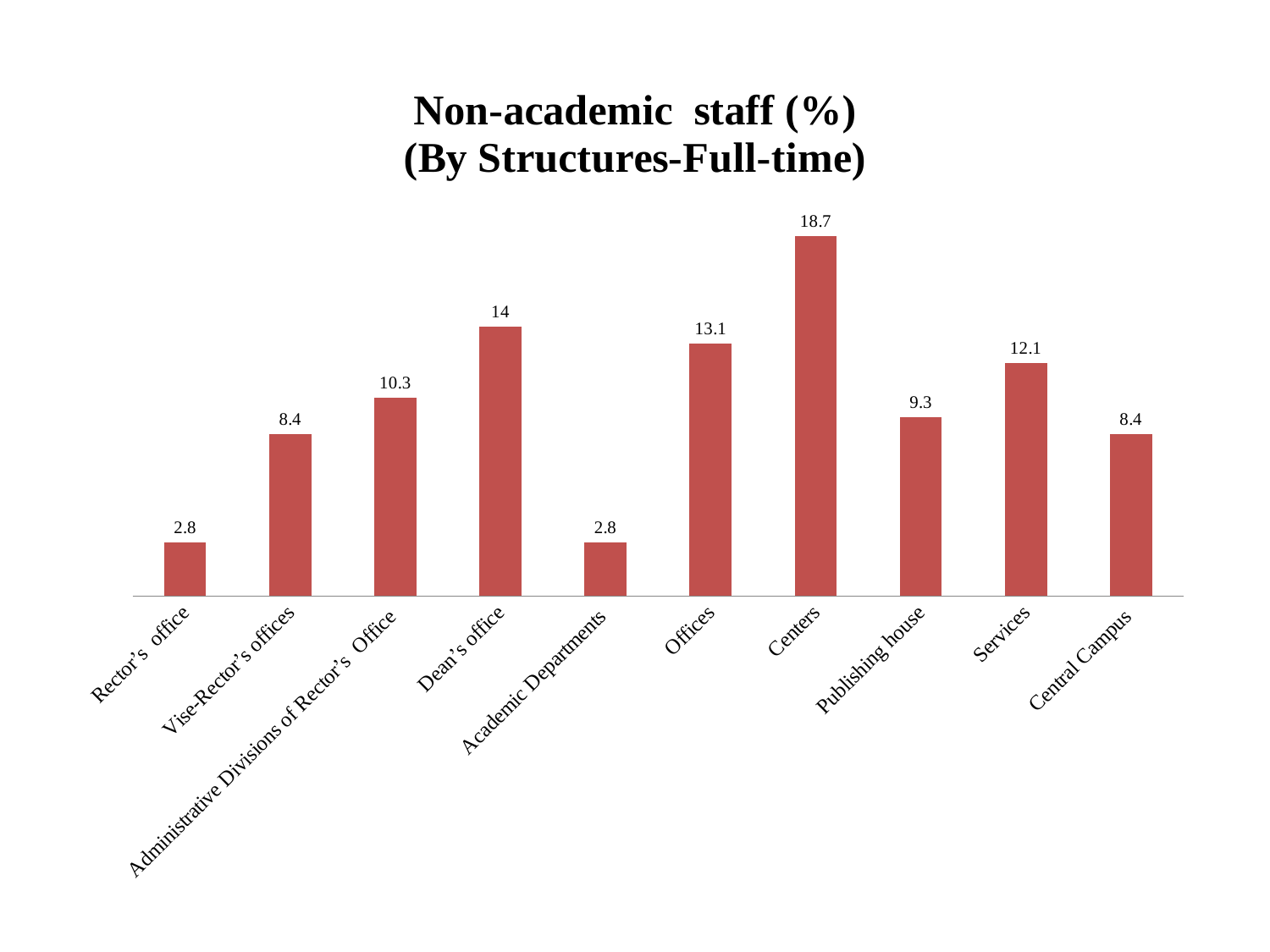
What is the difference between the values for Centers and Offices? 5.6 What is the value for Administrative Divisions of Rector's Office? 10.3 Which is larger, the value for Offices or the value for Services? Offices What is the difference between the values for Services and Vise-Rector's offices? 3.7 How many categories are shown on the x axis? 10 What is the value for Centers? 18.7 Which category has the highest value? Centers What kind of chart is this? Bar chart What is the title of the chart? Non-academic staff (%) (By Structures-Full-time) What is the value for Publishing house? 9.3 Which categories share the lowest value? Rector's office and Academic Departments What is the value for Dean's office? 14